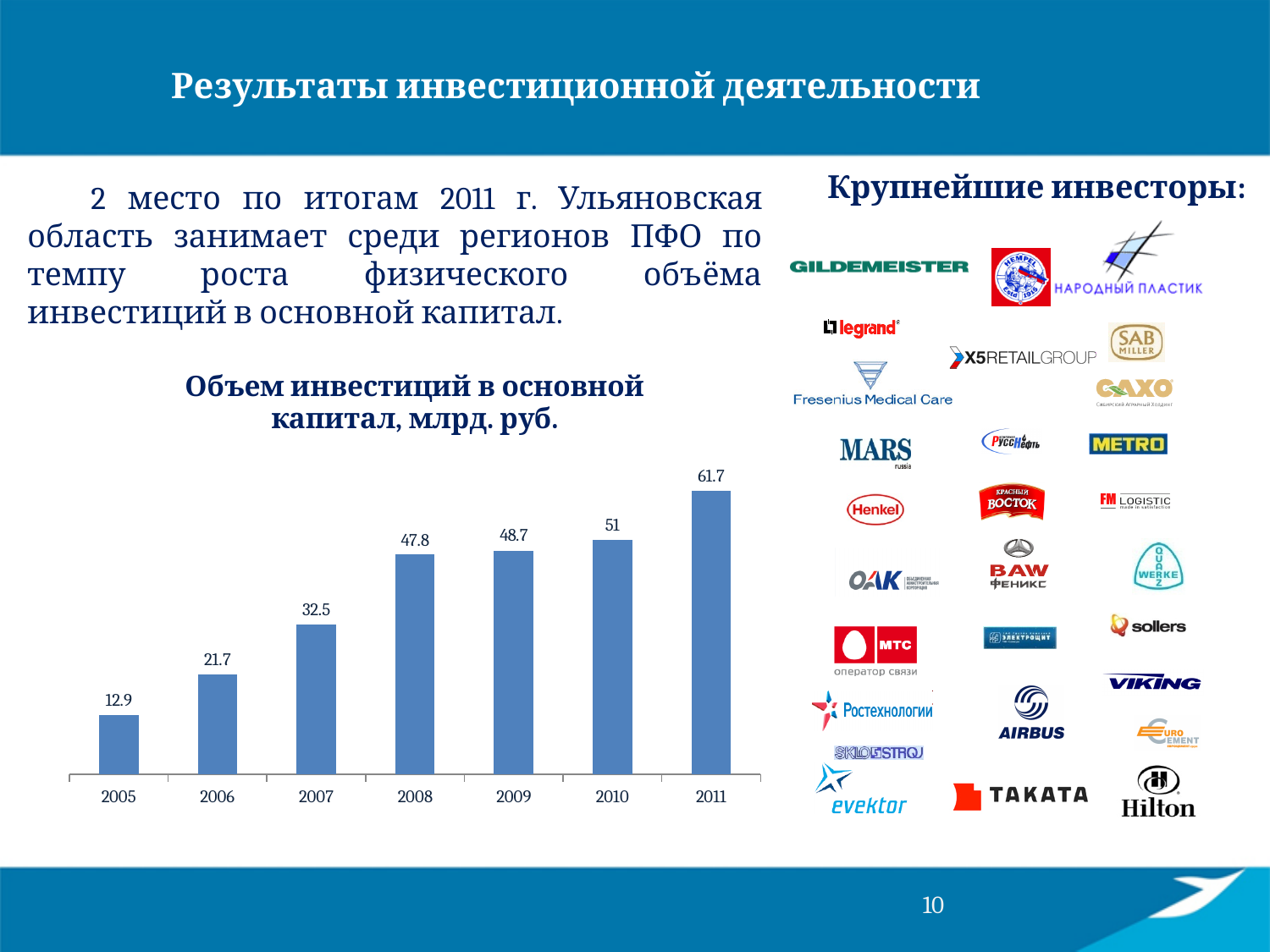
How many years are shown on the x axis? 7 What is the value for 2008? 47.8 What is the difference between the values for 2011 and 2010? 10.7 What is the title of the chart? Объем инвестиций в основной капитал, млрд. руб. What is the difference between the values for 2007 and 2006? 10.8 What kind of chart is this? bar chart Which is larger, the value for 2007 or the value for 2008? 2008 Which year has the lowest value? 2005 What is the value for 2005? 12.9 Which year has the highest value? 2011 Do the values rise or fall from 2005 to 2011? rise What is the value for 2011? 61.7